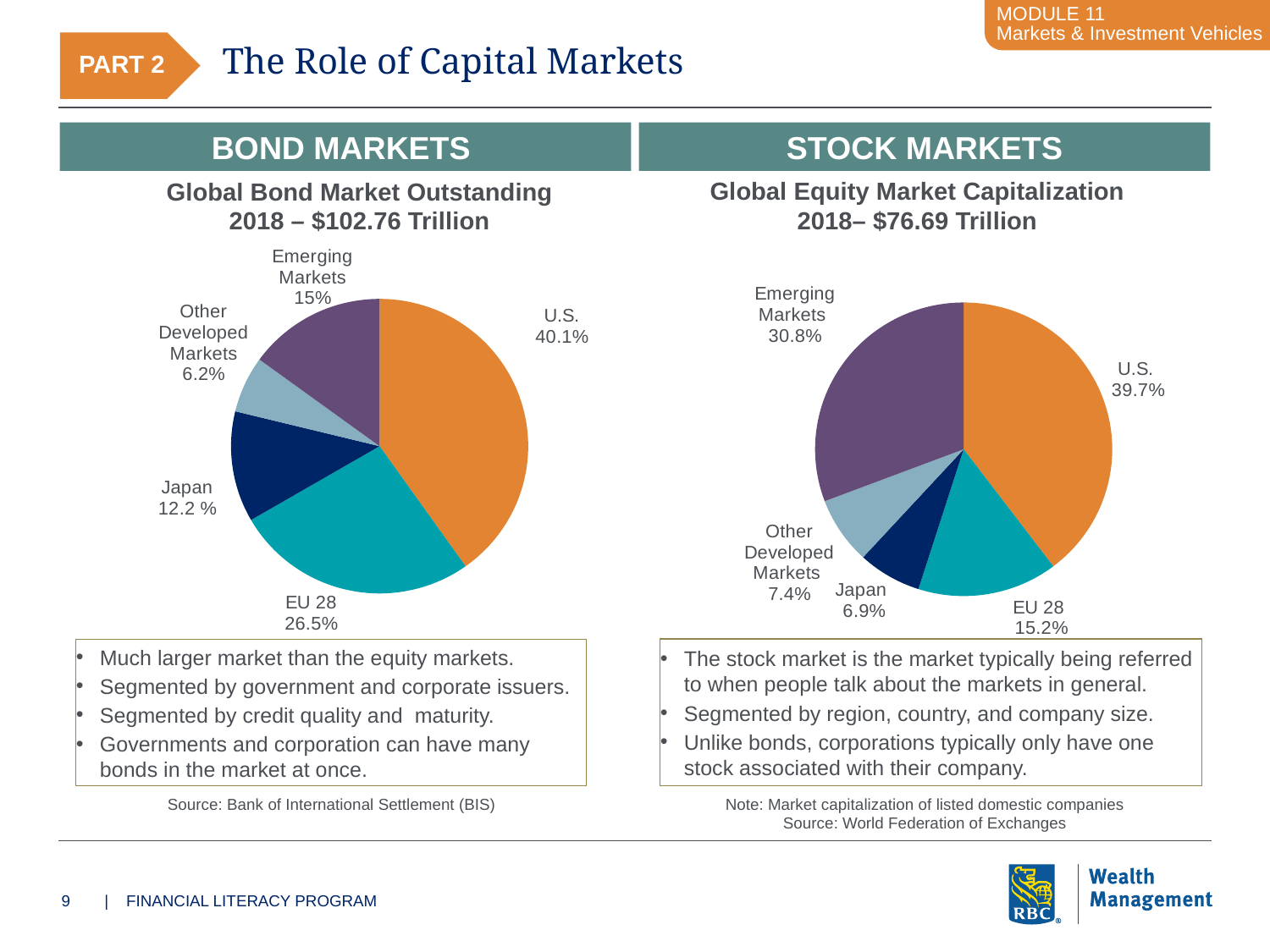
In the Global Bond Market Outstanding chart, what share do Emerging Markets hold? 15% In the Global Equity Market Capitalization chart, which is larger, the share for Other Developed Markets or the share for Japan? Other Developed Markets In the Global Equity Market Capitalization chart, what share does Japan hold? 6.9% In the Global Bond Market Outstanding chart, what share does EU 28 hold? 26.5% In the Global Bond Market Outstanding chart, what share does the U.S. hold? 40.1% How many slices does the Global Equity Market Capitalization chart have? 5 In the Global Equity Market Capitalization chart, what share do Emerging Markets hold? 30.8% In the Global Bond Market Outstanding chart, which region has the smallest share? Other Developed Markets In the Global Equity Market Capitalization chart, which region has the largest share? U.S. What total value is given in the title of the Global Equity Market Capitalization chart? $76.69 Trillion What type of chart is used for Global Bond Market Outstanding? Pie chart In the Global Bond Market Outstanding chart, what is the difference between the U.S. share and the EU 28 share? 13.6%